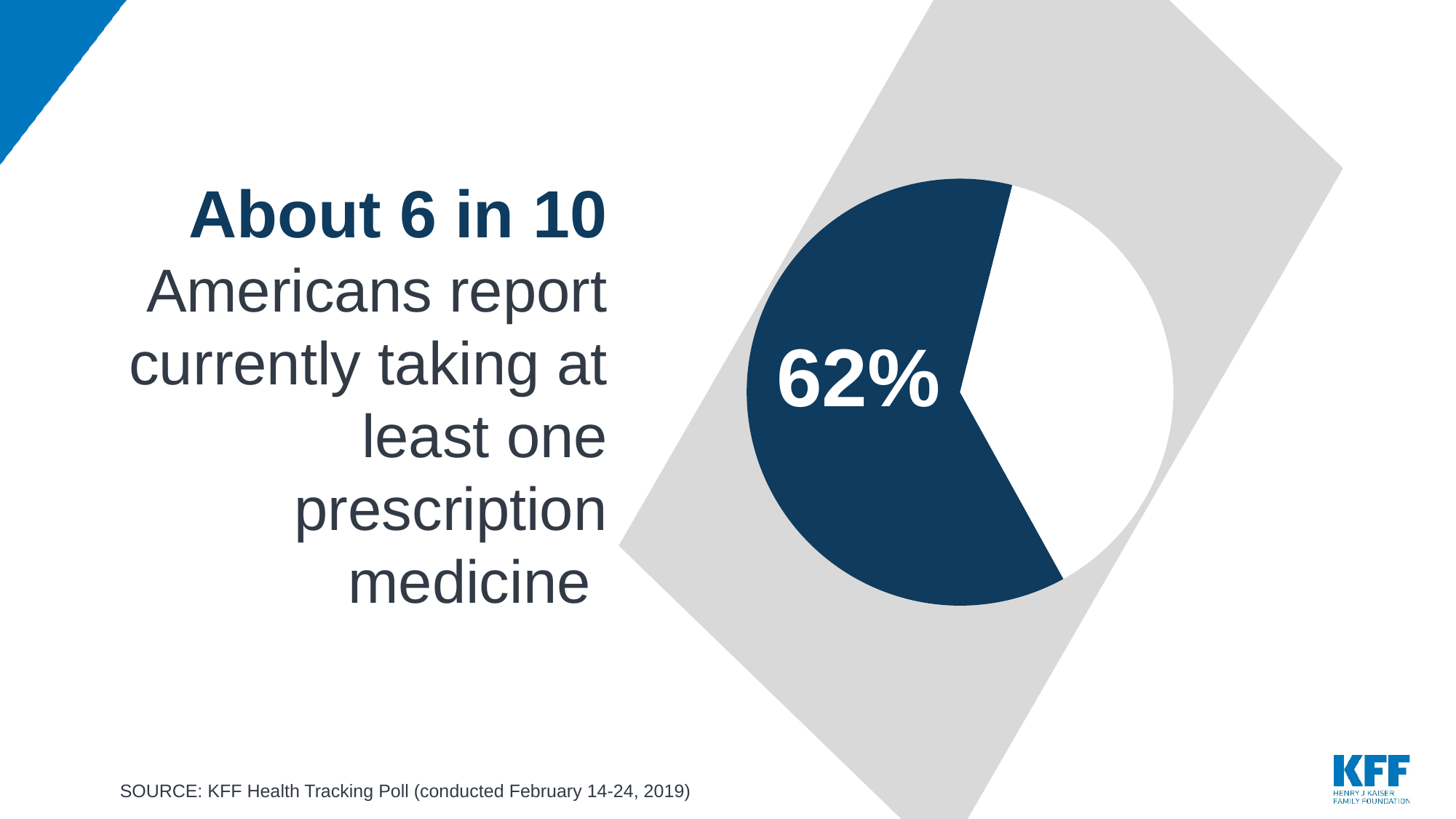
According to the slide text, what does the 62% slice represent? Americans who report currently taking at least one prescription medicine What colour is the slice labelled 62%? dark blue How many slices does the pie chart have? 2 What kind of chart is shown on the slide? pie chart Which slice of the pie chart is larger, the dark blue slice or the white slice? the dark blue slice What share of the pie does the dark blue slice represent? 62% What percentage is labelled on the dark blue slice of the pie chart? 62% Is the value of the labelled slice greater or less than 50%? greater